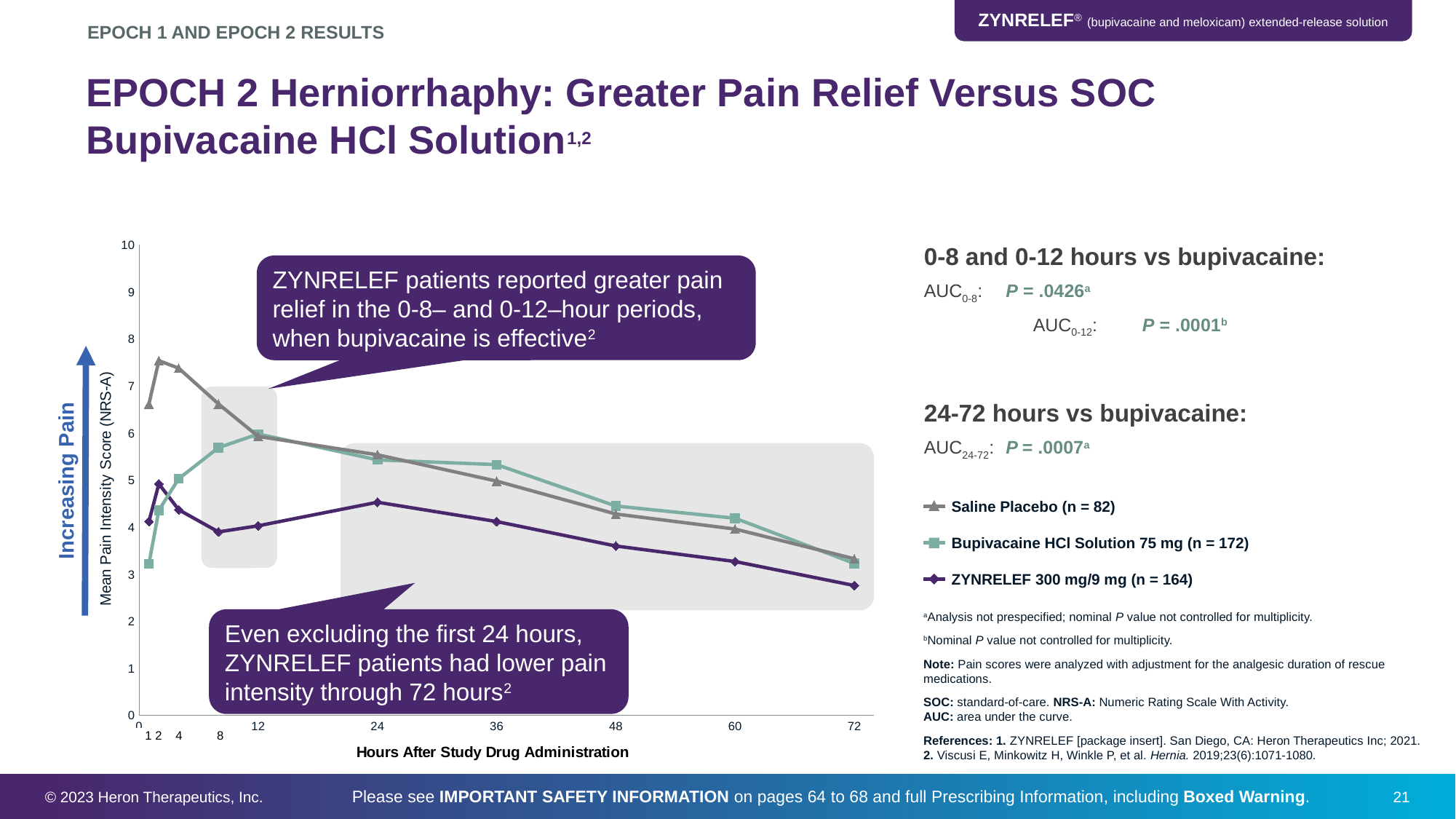
At 2 hours, which series has the higher mean pain intensity score: Saline Placebo or ZYNRELEF 300 mg/9 mg? Saline Placebo Does the ZYNRELEF 300 mg/9 mg line rise or fall from 24 hours to 72 hours? Fall At 48 hours, which series has the higher mean pain intensity score: Bupivacaine HCl Solution 75 mg or ZYNRELEF 300 mg/9 mg? Bupivacaine HCl Solution 75 mg How many series does the chart's legend list? 3 Is the ZYNRELEF 300 mg/9 mg value at 72 hours greater or less than 4? less Is the Bupivacaine HCl Solution 75 mg value at 1 hour greater or less than 4? less According to the legend, how many patients were in the ZYNRELEF 300 mg/9 mg group? n = 164 Is the ZYNRELEF 300 mg/9 mg value at 24 hours greater or less than 4? greater What is the title of the x axis of the chart? Hours After Study Drug Administration What kind of chart is shown on the slide? Line chart Which series has the lowest mean pain intensity score at 60 hours? ZYNRELEF 300 mg/9 mg